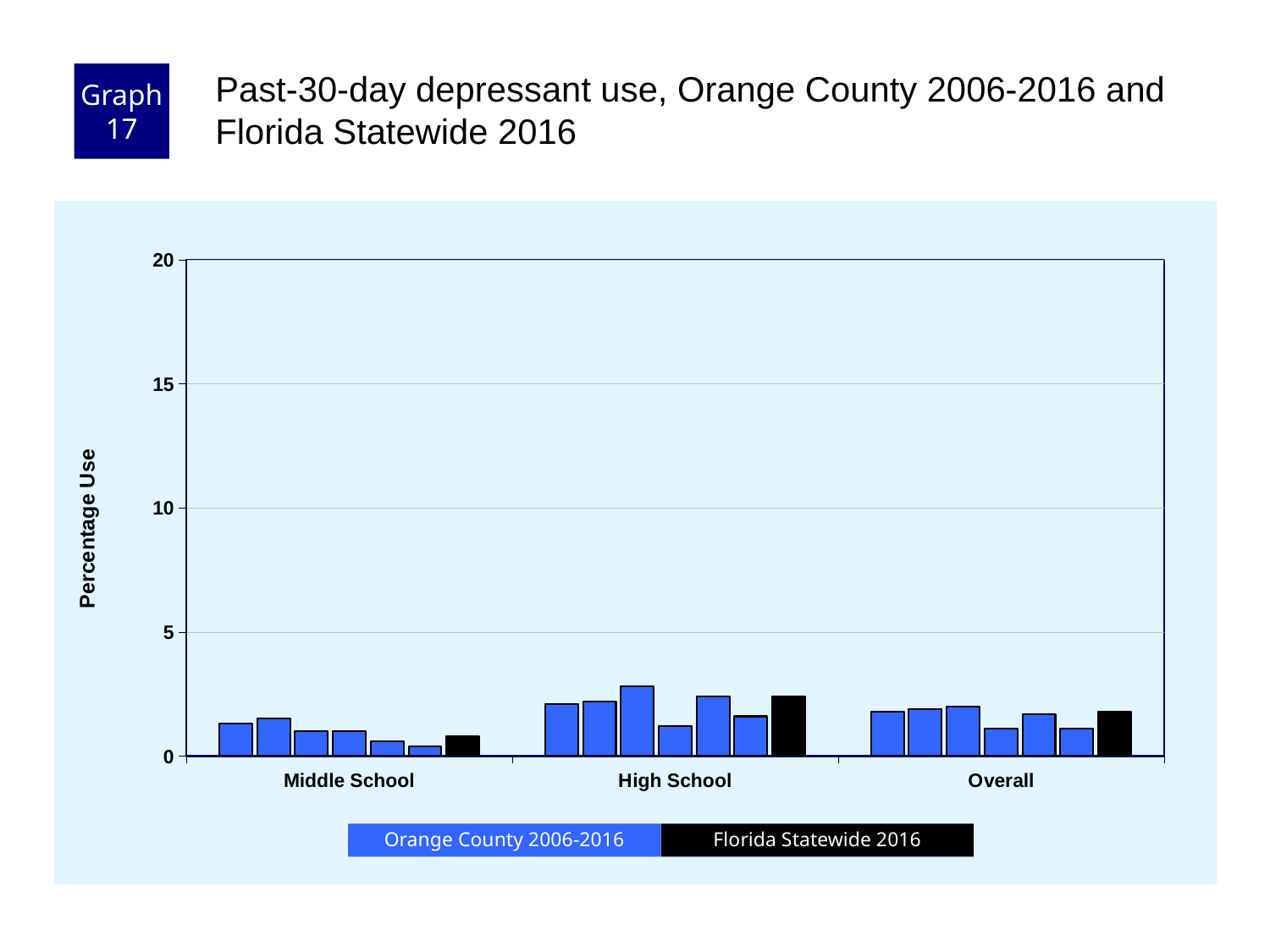
How many categories are shown on the x axis? 3 Which is larger, the Florida Statewide 2016 value for High School or for Middle School? High School Which is larger, the Florida Statewide 2016 value for Overall or for Middle School? Overall Is the Florida Statewide 2016 value for Middle School greater or less than 5? less Which category has the lowest Florida Statewide 2016 value? Middle School Which series is shown in black in the legend? Florida Statewide 2016 How many series does the legend list? 2 How many bars are plotted in the Middle School group? 7 Within the Middle School group, do the Orange County 2006-2016 bars generally rise or fall from left to right? fall What kind of chart is shown on the slide? bar chart What is the label on the y axis? Percentage Use Is the Florida Statewide 2016 value for High School greater or less than 5? less